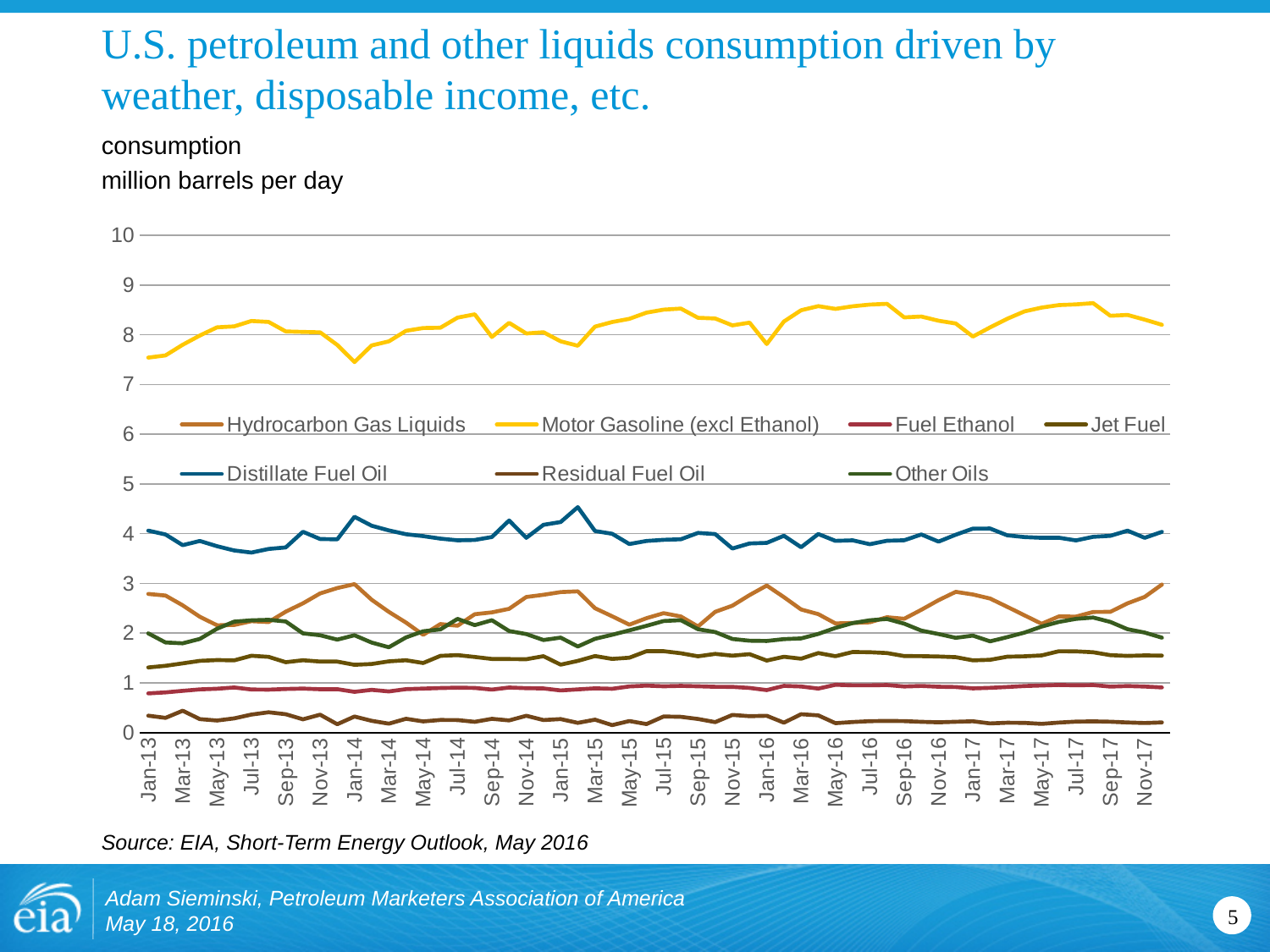
Is the value for Distillate Fuel Oil in Jan-15 greater or less than 4? greater Which is larger in Jan-14, Distillate Fuel Oil or Hydrocarbon Gas Liquids? Distillate Fuel Oil Is the value for Motor Gasoline (excl Ethanol) in Jul-16 greater or less than 8? greater Which series has the lowest consumption throughout the chart? Residual Fuel Oil Is the value for Fuel Ethanol in Jan-13 greater or less than 1? less What unit is consumption measured in on the chart? million barrels per day Which series has the highest consumption throughout the chart? Motor Gasoline (excl Ethanol) How many series does the legend list? 7 What kind of chart is shown on the slide? line chart Does Motor Gasoline (excl Ethanol) consumption overall rise or fall from Jan-13 to Nov-17? rise